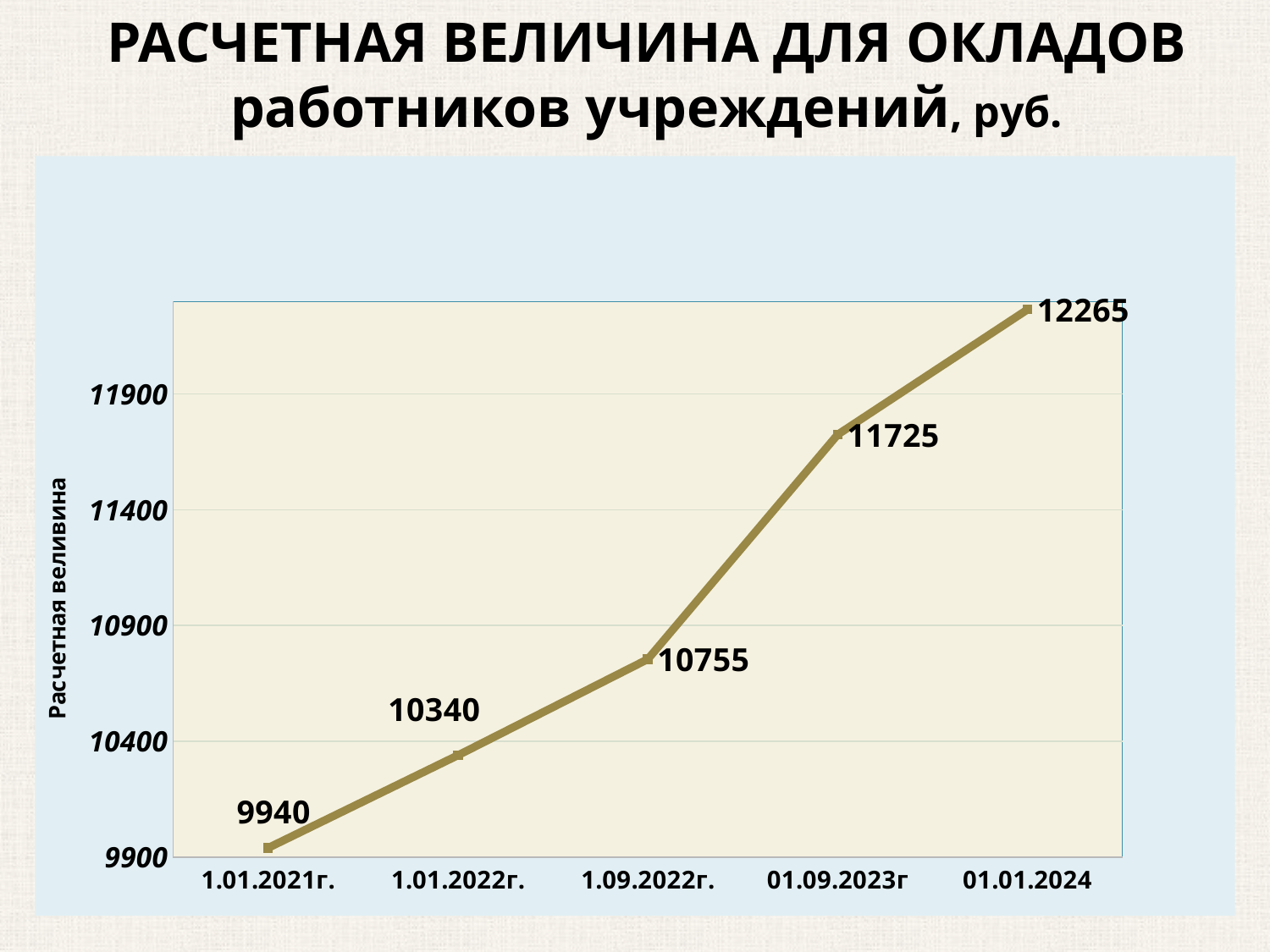
Which date has the lowest value? 1.01.2021г. What is the difference between the values for 1.01.2022г. and 1.01.2021г.? 400 What is the difference between the values for 01.01.2024 and 01.09.2023г? 540 How many data points are plotted on the chart? 5 Which is larger, the value for 1.09.2022г. or the value for 1.01.2022г.? 1.09.2022г. Is the value for 01.09.2023г greater or less than 11400? greater Do the values rise or fall from 1.01.2021г. to 01.01.2024? rise What is the value for 1.01.2021г.? 9940 What kind of chart is shown on the slide? line chart Which date has the highest value? 01.01.2024 What is the value for 1.09.2022г.? 10755 What is the value for 01.01.2024? 12265